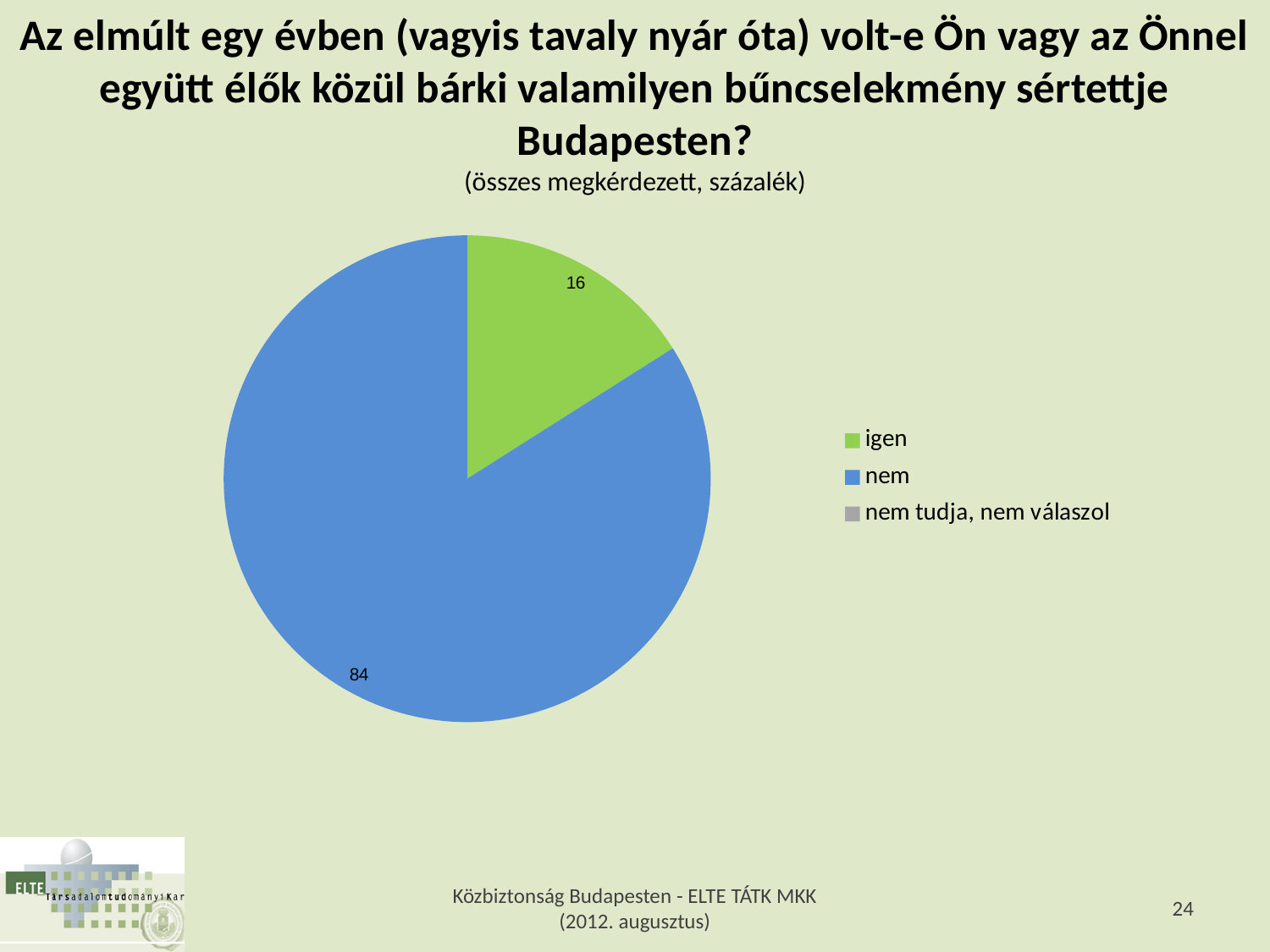
What is the value for "nem"? 84 What colour is the "igen" slice? green Which is larger, the value for "igen" or the value for "nem"? nem What colour is the "nem" slice? blue How many entries does the legend list? 3 What kind of chart is shown on the slide? pie chart What is the difference between the values for "nem" and "igen"? 68 Which of the two labelled slices is smaller, "igen" or "nem"? igen What is the total of the two labelled slices, "igen" and "nem"? 100 What is the value for "igen"? 16 How many slices have a data label printed on the pie? 2 Which category has the largest slice of the pie? nem